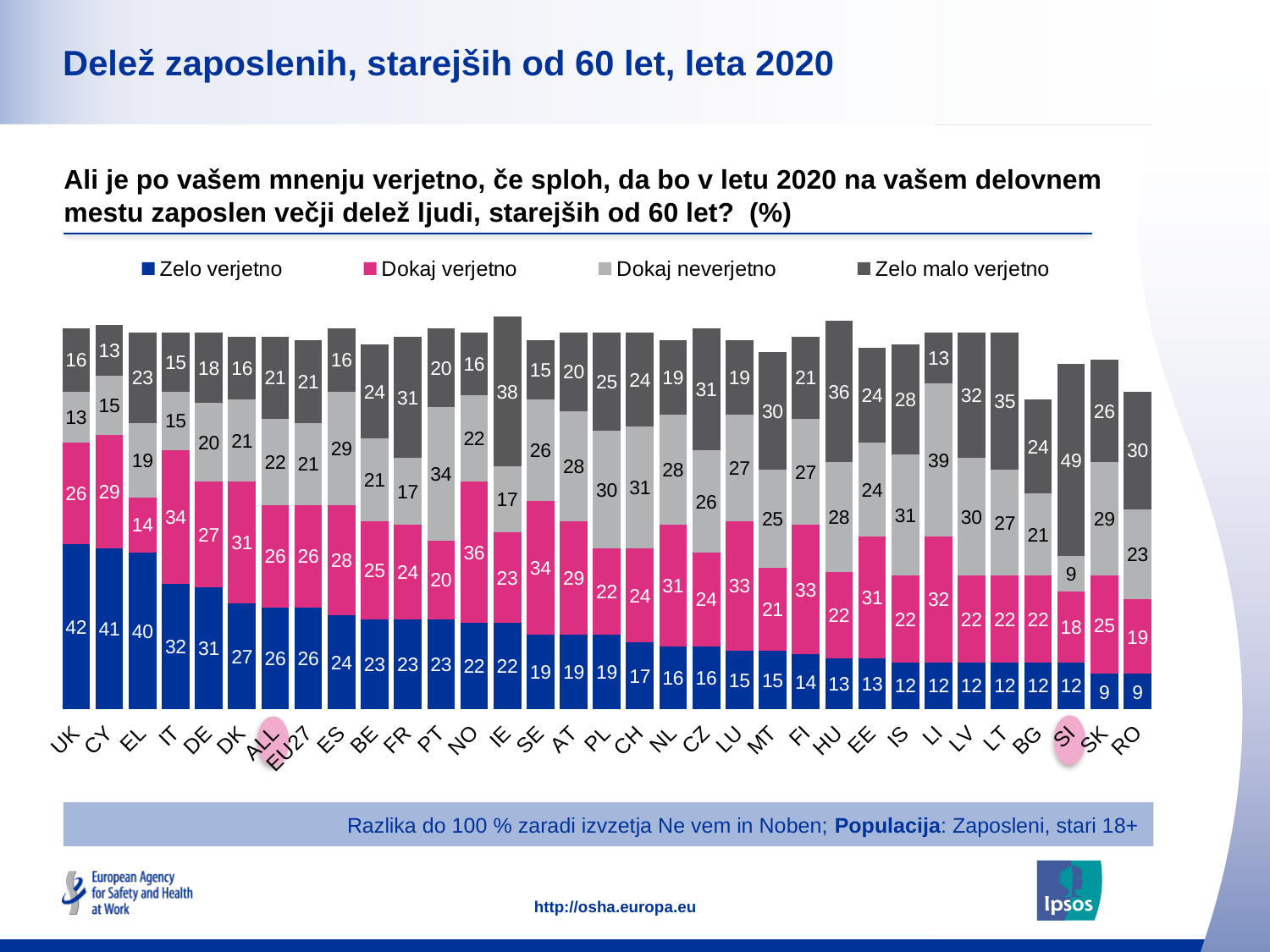
What is the difference between the "Zelo verjetno" values for UK and IT? 10 Which is larger, the "Dokaj verjetno" value for IT or for EL? IT What kind of chart is shown on the slide? Stacked bar chart How many series does the legend list? 4 What is the value of "Dokaj neverjetno" for LI? 39 What is the value of "Zelo malo verjetno" for IE? 38 Which country has the highest value for "Zelo malo verjetno"? SI How many countries or regions are shown on the x axis? 33 What is the value of "Zelo verjetno" for UK? 42 What is the total of the stacked bar for UK? 97 What is the value of "Dokaj verjetno" for NO? 36 Which country has the highest value for "Zelo verjetno"? UK